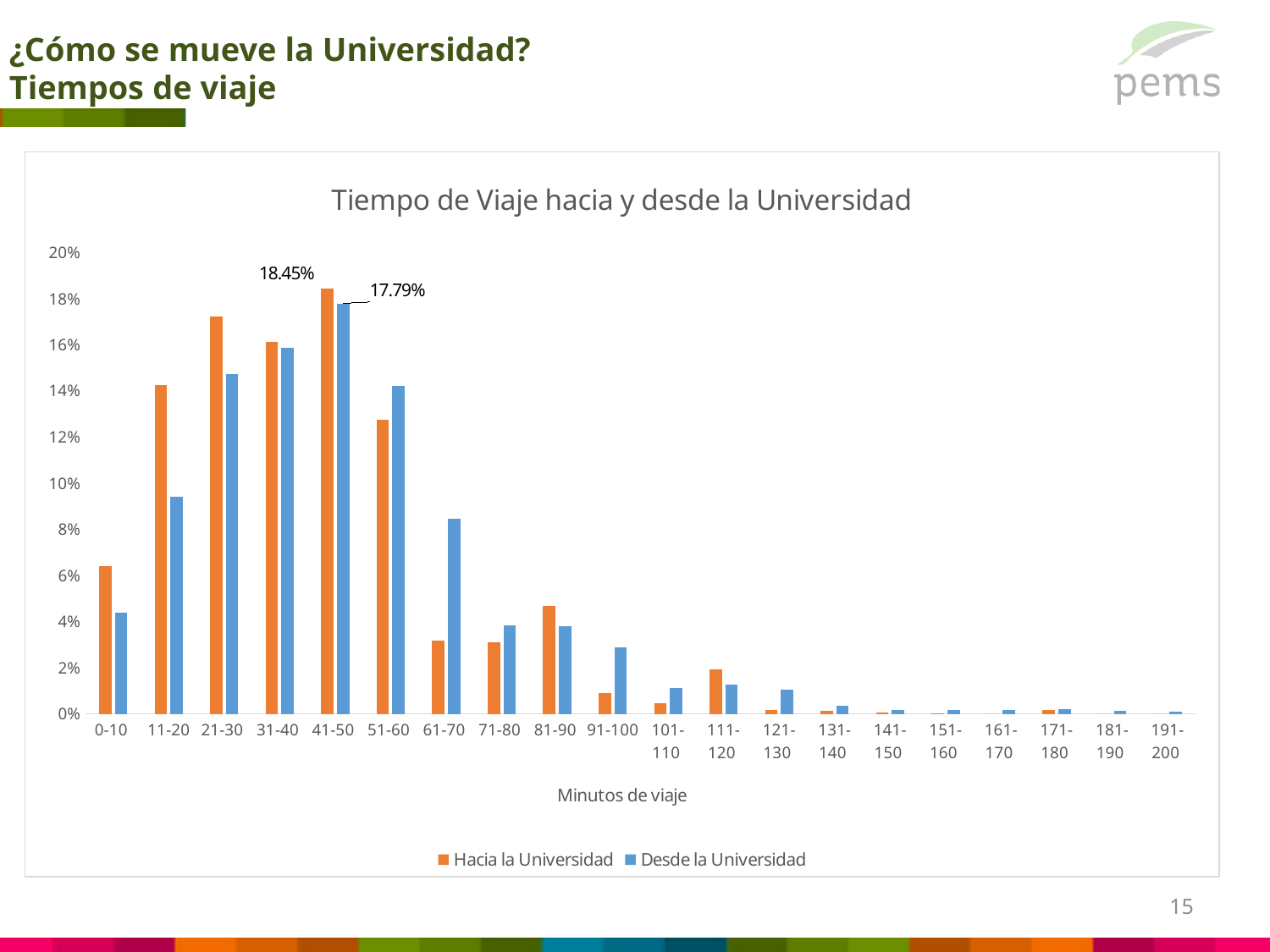
In the 11-20 category, which series has the larger value? Hacia la Universidad Is the value for Desde la Universidad in the 51-60 category greater or less than 12%? greater In the 61-70 category, which series has the larger value? Desde la Universidad What is the difference between the Hacia la Universidad and Desde la Universidad values in the 41-50 category? 0.66% How many series does the legend list? 2 What is the value for Hacia la Universidad in the 41-50 category? 18.45% What is the value for Desde la Universidad in the 41-50 category? 17.79% What kind of chart is shown? bar chart Which category has the highest value for Hacia la Universidad? 41-50 Which category has the highest value for Desde la Universidad? 41-50 How many categories are shown on the x axis? 20 What is the x-axis title of the chart? Minutos de viaje